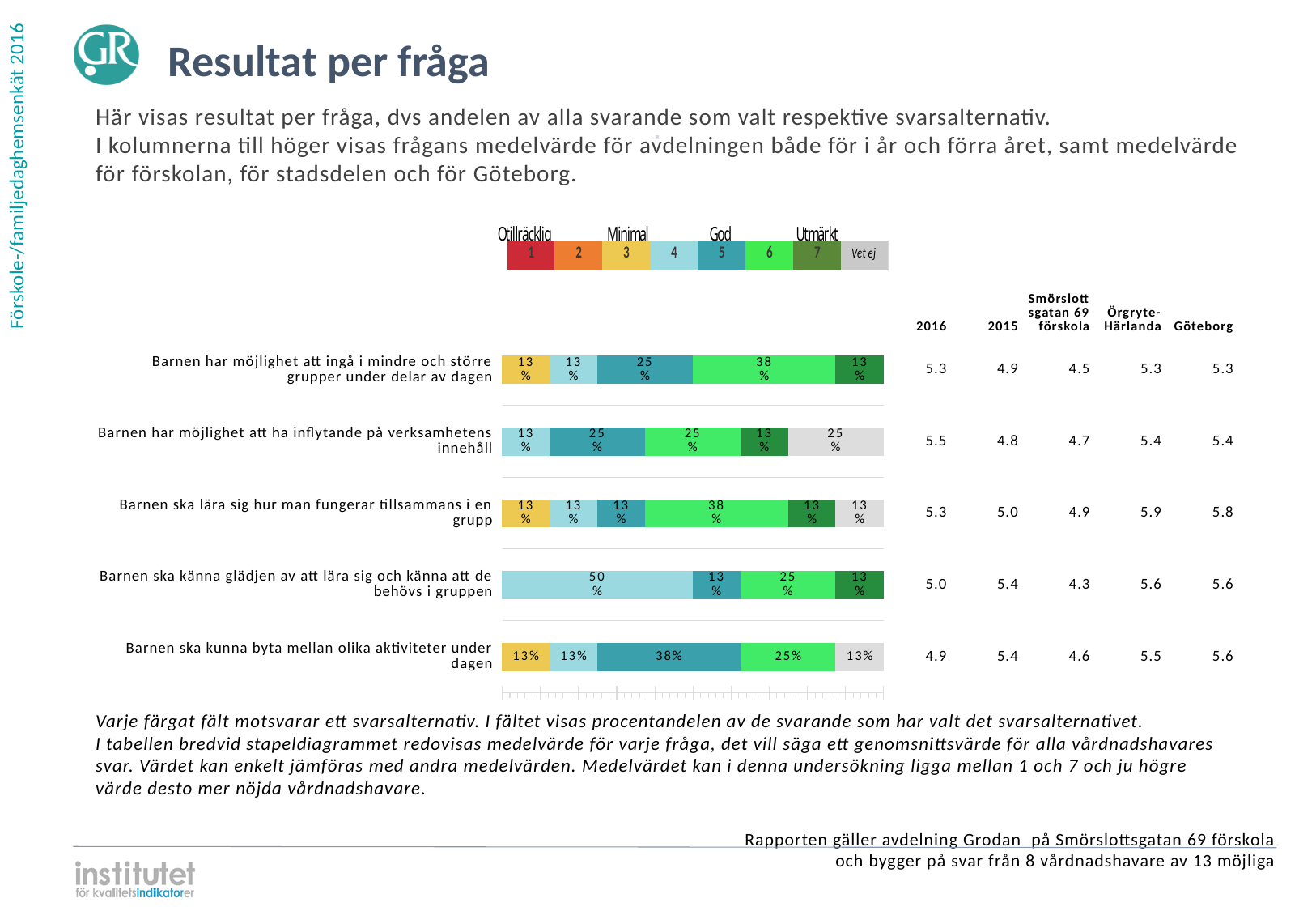
For 'Barnen ska kunna byta mellan olika aktiviteter under dagen', what is the difference between the share for answer 5 and the share for answer 6? 13% What is the 2016 mean value shown for 'Barnen har möjlighet att ha inflytande på verksamhetens innehåll'? 5.5 How many questions (categories) are plotted in the bar chart? 5 How many answer alternatives does the legend above the chart list? 8 What share of respondents chose answer 6 (bright green) for 'Barnen har möjlighet att ingå i mindre och större grupper under delar av dagen'? 38% What share of respondents chose answer 5 (teal) for 'Barnen ska kunna byta mellan olika aktiviteter under dagen'? 38% For 'Barnen har möjlighet att ha inflytande på verksamhetens innehåll', is the share for answer 5 larger or smaller than the share for answer 7? Larger What share of respondents chose answer 4 (light blue) for 'Barnen ska känna glädjen av att lära sig och känna att de behövs i gruppen'? 50% What kind of chart is shown on the slide? Stacked bar chart Which colour represents answer alternative 1 in the legend? Red What share of respondents answered 'Vet ej' for 'Barnen har möjlighet att ha inflytande på verksamhetens innehåll'? 25% Which answer alternative has the largest share for 'Barnen ska lära sig hur man fungerar tillsammans i en grupp'? 6